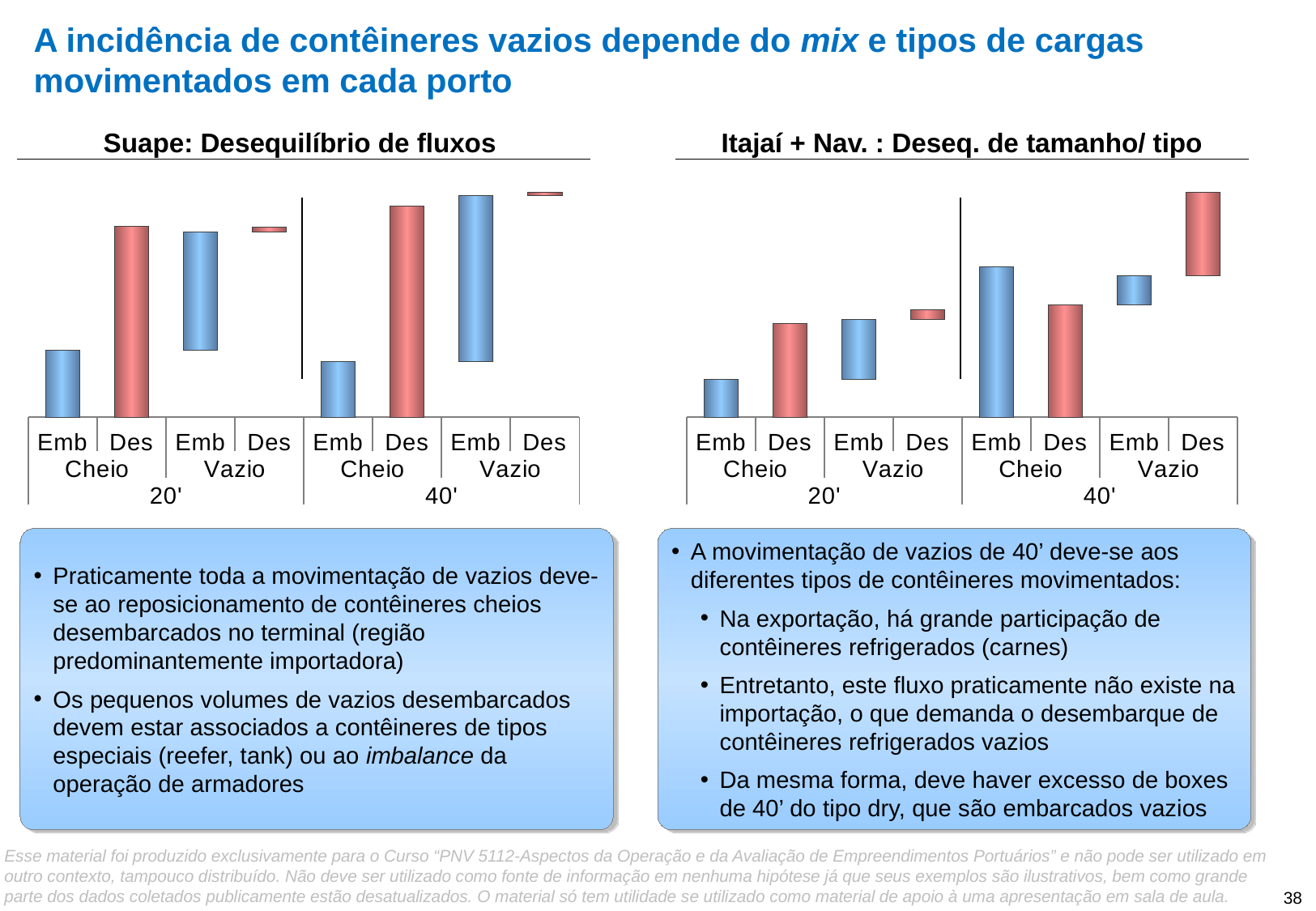
How many charts are shown on the slide? 2 In the Suape: Desequilíbrio de fluxos chart, what colour are the Emb bars? blue In the Itajaí + Nav. : Deseq. de tamanho/ tipo chart, which is taller for 20' Cheio: the Emb bar or the Des bar? Des How many container size groups (20', 40') are shown on the x axis of the Suape: Desequilíbrio de fluxos chart? 2 How many bars are plotted in the Suape: Desequilíbrio de fluxos chart? 8 In the Suape: Desequilíbrio de fluxos chart, which is taller for 20' Cheio: the Emb bar or the Des bar? Des In the Itajaí + Nav. : Deseq. de tamanho/ tipo chart, which Cheio Emb bar is taller: 20' or 40'? 40' What kind of chart is the Suape: Desequilíbrio de fluxos chart? bar chart What is the title of the chart on the left of the slide? Suape: Desequilíbrio de fluxos